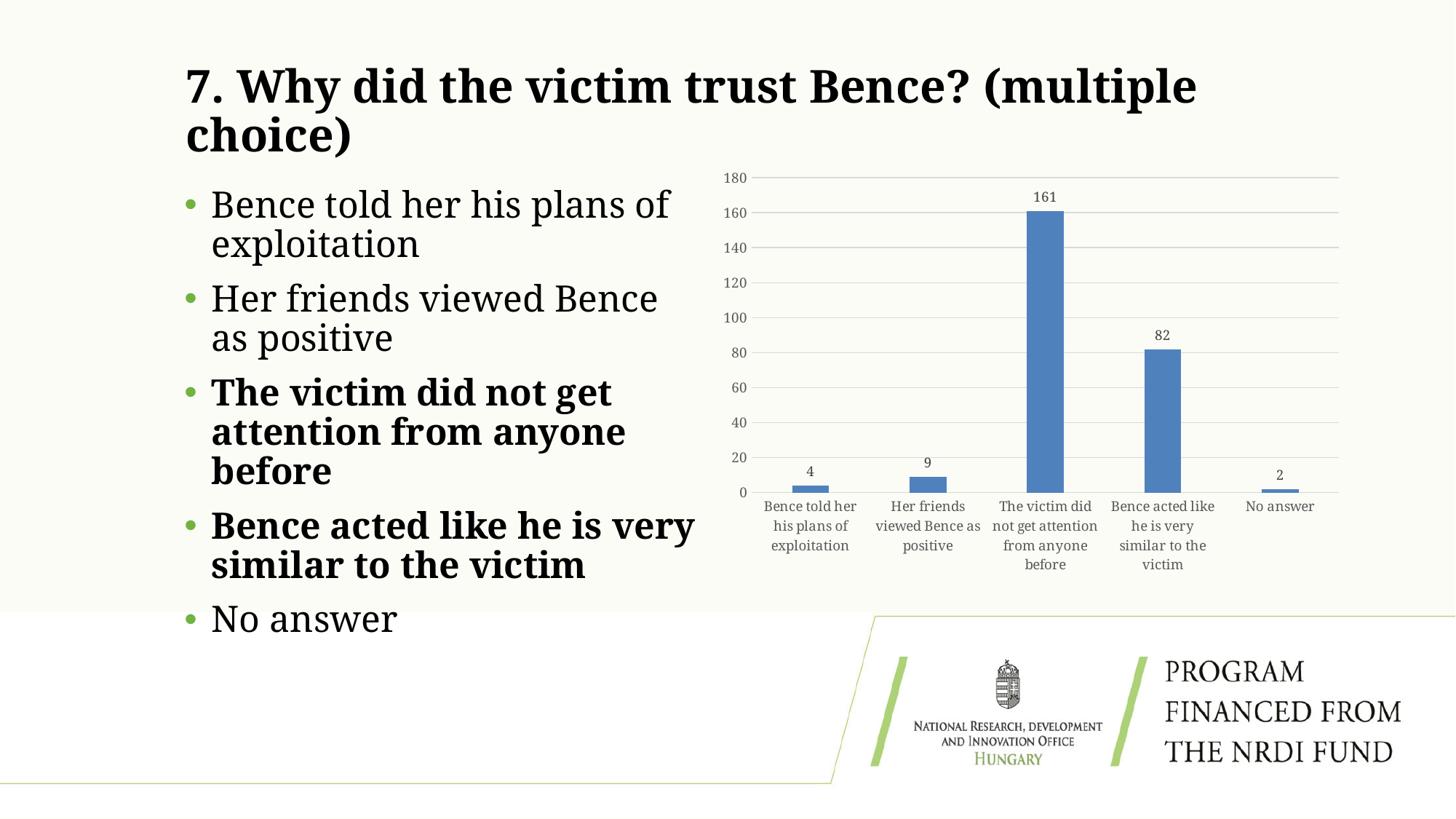
Which is larger: the value for "Her friends viewed Bence as positive" or the value for "Bence told her his plans of exploitation"? Her friends viewed Bence as positive Is the value for "Bence acted like he is very similar to the victim" greater or less than 100? less What is the value for "Her friends viewed Bence as positive"? 9 Which category has the lowest value? No answer How many categories are shown on the chart? 5 What is the value for "Bence acted like he is very similar to the victim"? 82 What is the difference between the values for "The victim did not get attention from anyone before" and "Bence acted like he is very similar to the victim"? 79 What is the value for "Bence told her his plans of exploitation"? 4 What kind of chart is shown on the slide? bar chart Which category has the highest value? The victim did not get attention from anyone before What is the value for "The victim did not get attention from anyone before"? 161 What is the value for "No answer"? 2